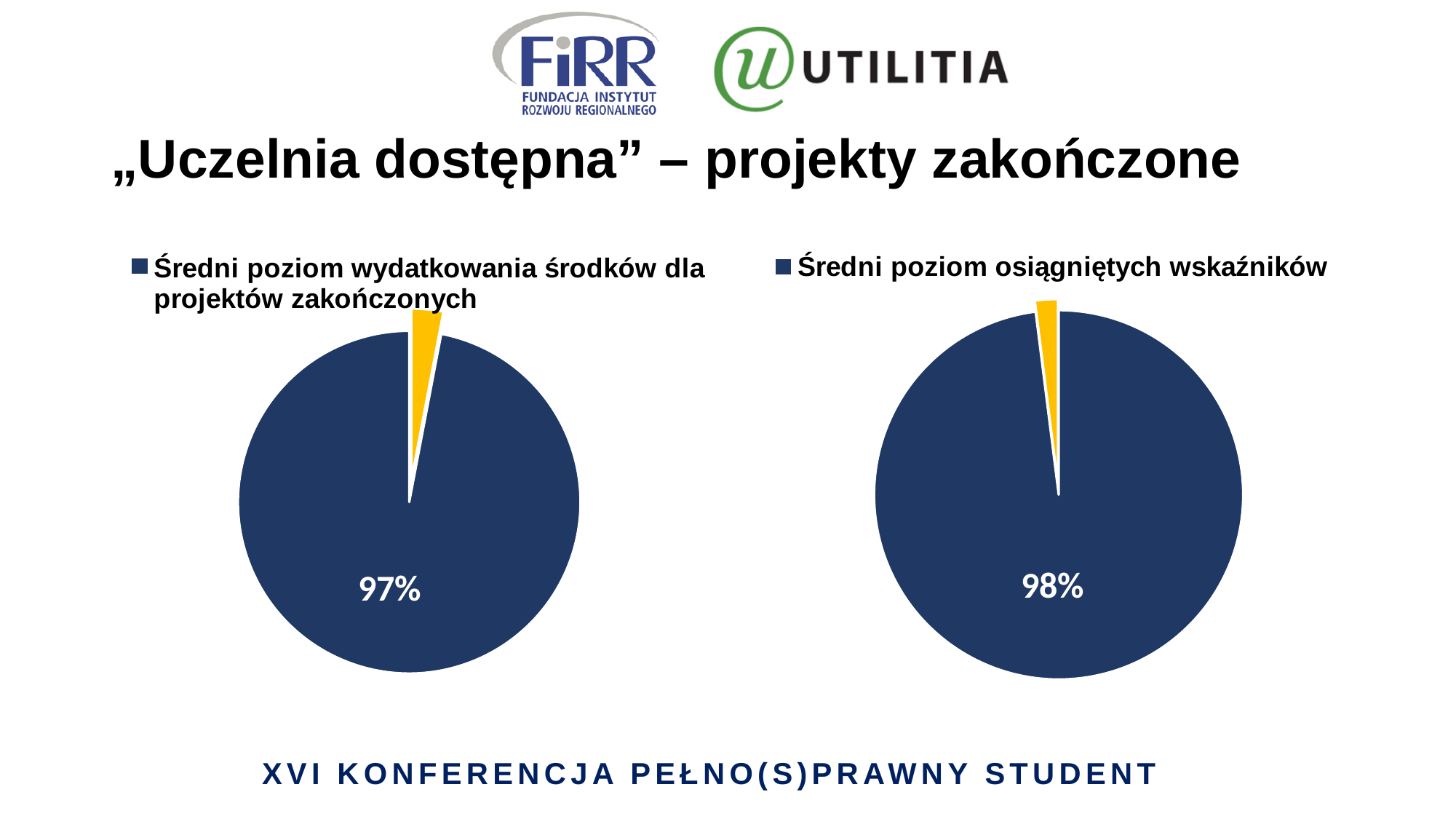
What kind of chart is the right chart on the slide? Pie chart In the left pie chart, what share of the pie does the blue slice represent? 97% In the left pie chart, what value is printed on the large blue slice? 97% What is the difference between the labelled value in the right pie chart and the labelled value in the left pie chart? 1 percentage point How many slices does the left pie chart have? 2 In the right pie chart, what value is printed on the large blue slice? 98% Which chart shows the larger labelled value, the left pie chart (97%) or the right pie chart (98%)? The right pie chart How many slices does the right pie chart have? 2 How many entries does the legend of the left pie chart list? 1 What colour is the small slice in the left pie chart? Yellow What is the legend entry of the right pie chart? Średni poziom osiągniętych wskaźników What kind of chart is the left chart on the slide? Pie chart